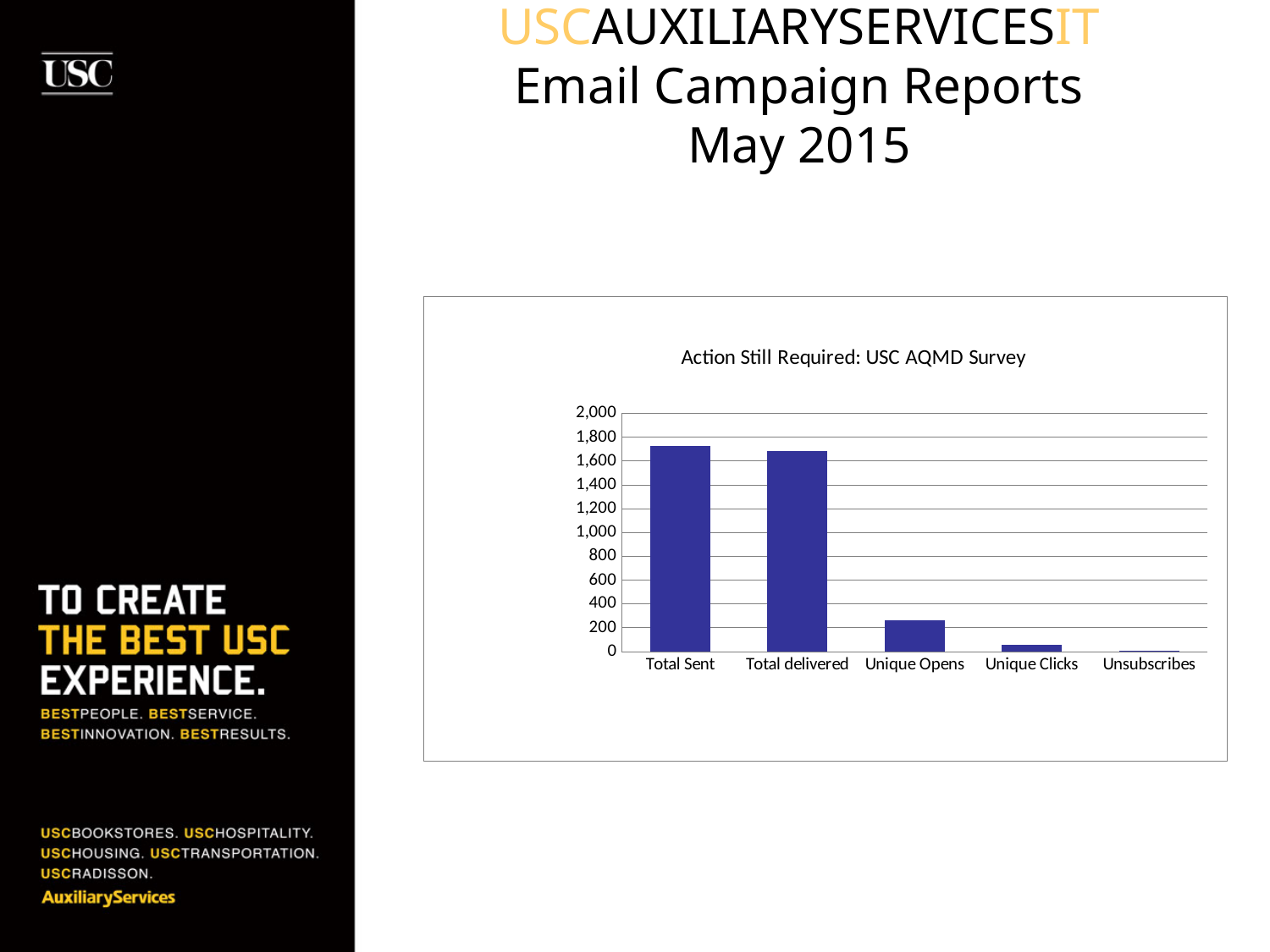
Do the values rise or fall moving from left to right along the x axis? fall Is the value for Total delivered greater or less than 1,400? greater Which is larger, the value for Unique Opens or the value for Unique Clicks? Unique Opens What is the highest value shown on the vertical axis of the chart? 2,000 What is the title of the chart? Action Still Required: USC AQMD Survey Which category has the lowest value in the chart? Unsubscribes What type of chart is shown on the slide? bar chart Is the value for Unique Clicks greater or less than 200? less How many categories are shown on the x axis of the chart? 5 Which category has the highest value in the chart? Total Sent Is the value for Unique Opens greater or less than 400? less